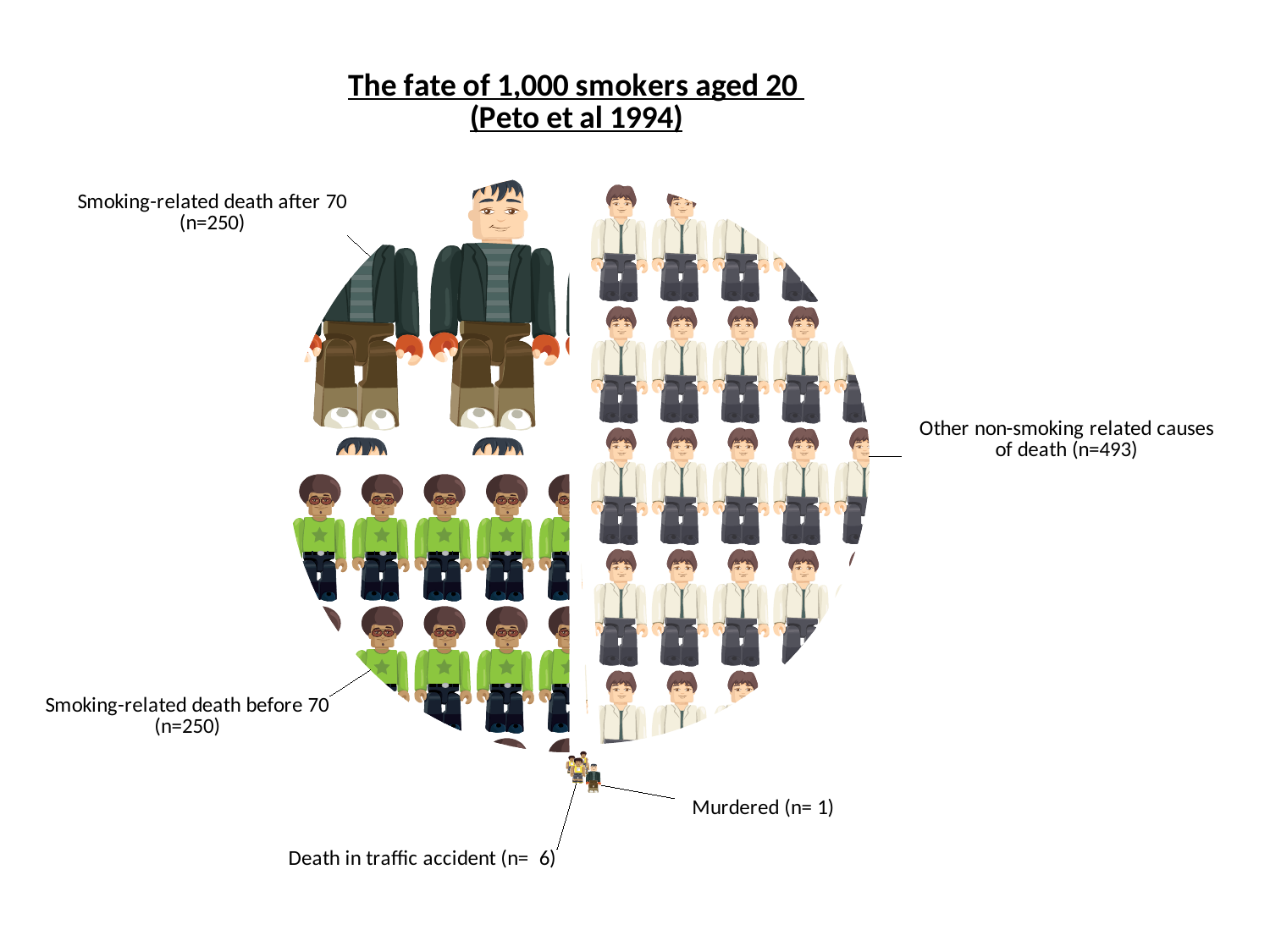
What kind of chart is shown on the slide? Pie chart Which category accounts for the largest number of deaths? Other non-smoking related causes of death How many smokers have a smoking-related death before 70? 250 How many categories does the pie chart show? 5 How many smokers die in a traffic accident? 6 What is the difference between the number of deaths from other non-smoking related causes and the number of smoking-related deaths after 70? 243 What is the title of the chart? The fate of 1,000 smokers aged 20 (Peto et al 1994) How many smokers are murdered? 1 What share of the 1,000 smokers die of other non-smoking related causes of death? 49.3% How many smokers die of other non-smoking related causes of death? 493 Which is larger: the number of deaths in traffic accidents or the number murdered? Death in traffic accident Which category accounts for the smallest number of deaths? Murdered